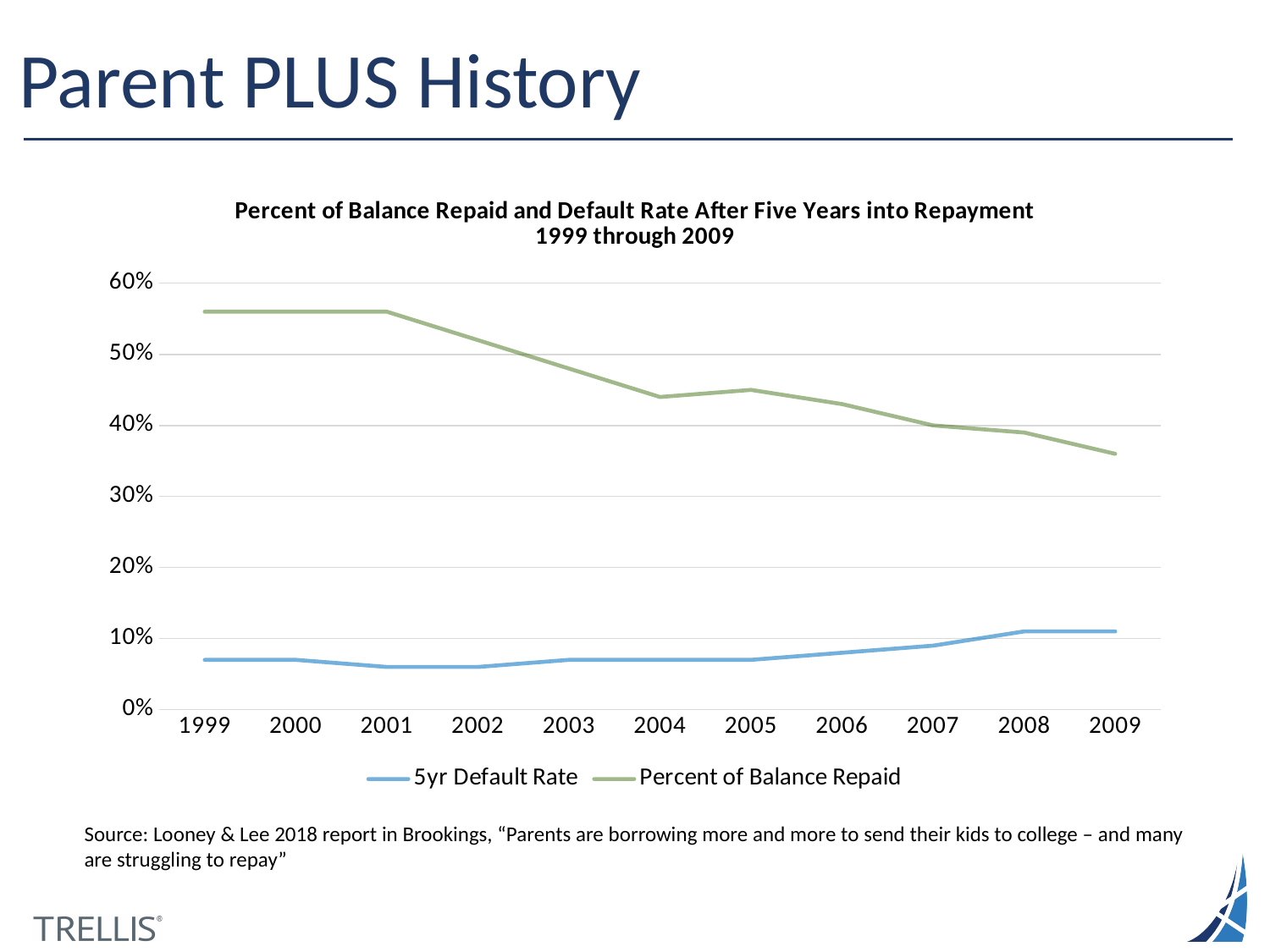
Is the value for Percent of Balance Repaid in 2004 greater or less than 50%? less Is the value for Percent of Balance Repaid in 2009 greater or less than 40%? less Which is larger, Percent of Balance Repaid in 2004 or in 2009? 2004 Does the Percent of Balance Repaid line rise or fall from 1999 to 2009? fall Is the value for 5yr Default Rate in 2009 greater or less than 10%? greater What is the title of the chart? Percent of Balance Repaid and Default Rate After Five Years into Repayment 1999 through 2009 How many years are plotted along the x axis? 11 How many series does the legend list? 2 In which year is Percent of Balance Repaid lowest? 2009 What kind of chart is shown on the slide? line chart